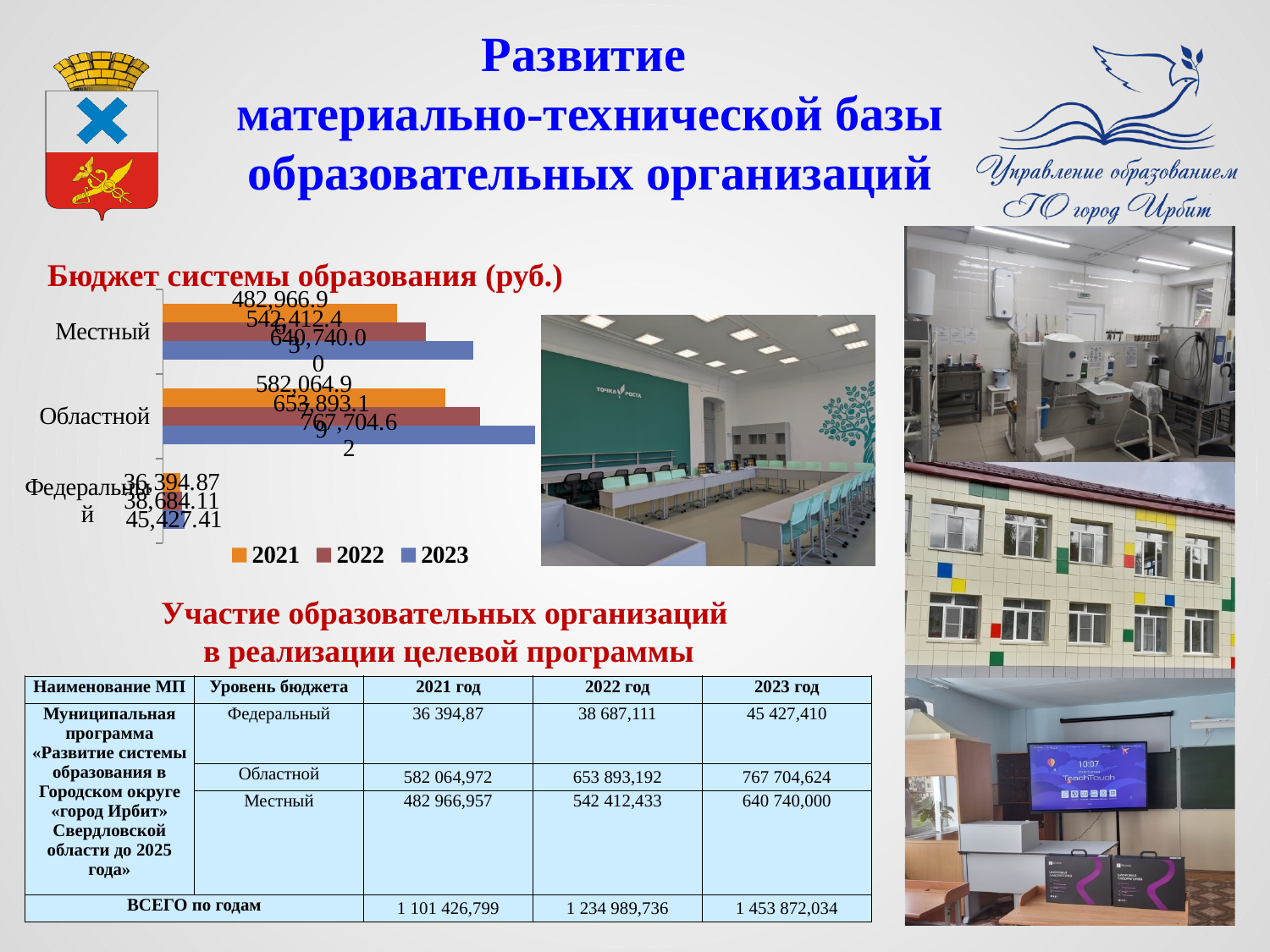
How many budget-level categories are shown on the 'Бюджет системы образования (руб.)' chart? 3 Which category has the longest bar in the 'Бюджет системы образования (руб.)' chart? Областной In the 'Бюджет системы образования (руб.)' chart, do the Местный values rise or fall from 2021 to 2023? rise What colour represents the 2021 series in the 'Бюджет системы образования (руб.)' chart? orange How many series does the legend of the 'Бюджет системы образования (руб.)' chart list? 3 In the 'Бюджет системы образования (руб.)' chart, do the Областной values rise or fall from 2021 to 2023? rise Which series in the 'Бюджет системы образования (руб.)' chart has the longest bar for Областной? 2023 What kind of chart is used to show the 'Бюджет системы образования (руб.)' data? bar chart In the 'Бюджет системы образования (руб.)' chart, which is larger for 2023: Областной or Местный? Областной Which years are listed in the legend of the 'Бюджет системы образования (руб.)' chart? 2021, 2022, 2023 In the 'Бюджет системы образования (руб.)' chart, which is larger for 2021: Местный or Федеральный? Местный Which category has the shortest bars in the 'Бюджет системы образования (руб.)' chart? Федеральный